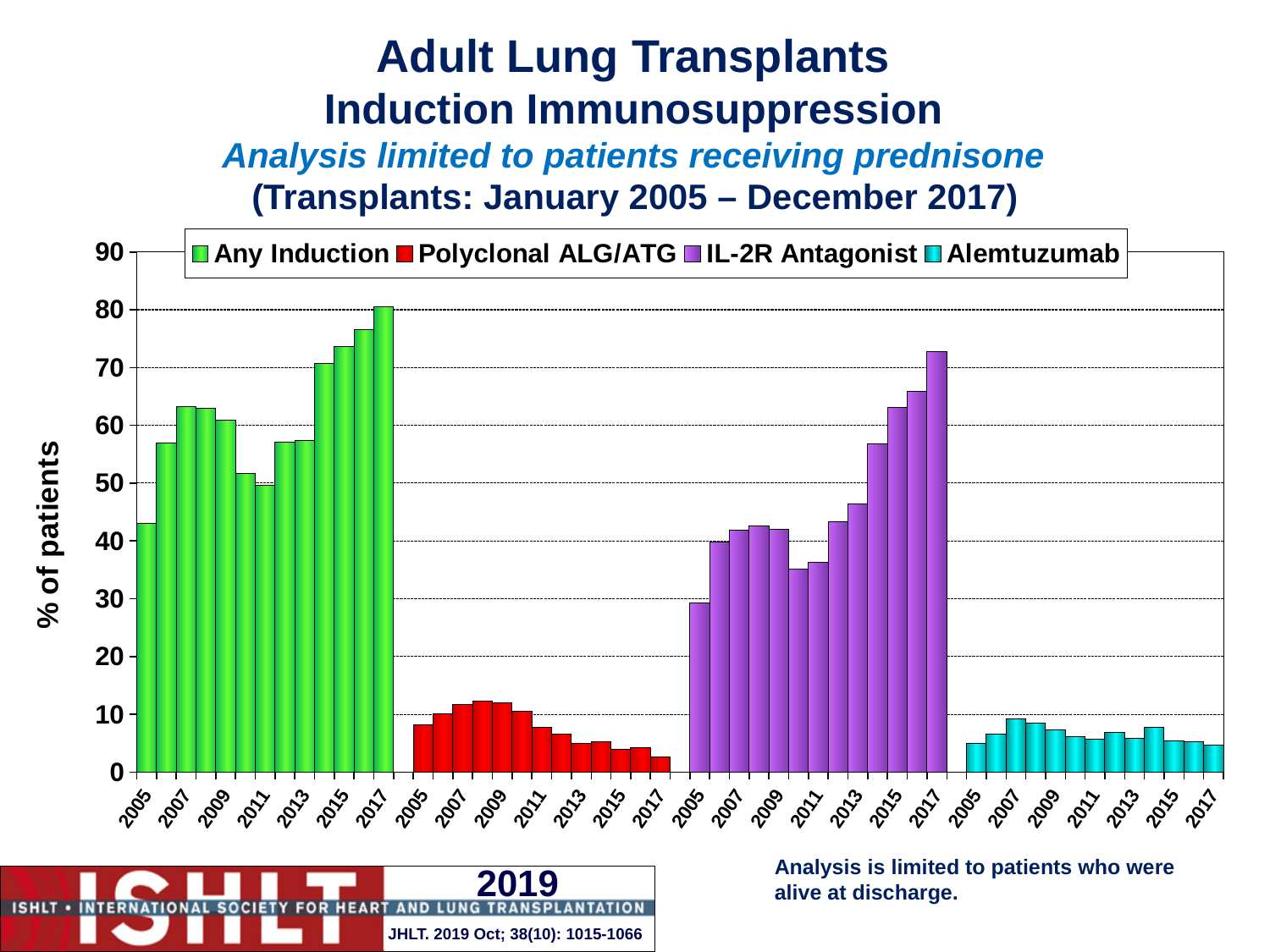
How many series does the legend list? 4 What kind of chart is shown on the slide? Bar chart In which year is the IL-2R Antagonist value highest? 2017 Which is larger in 2017: the IL-2R Antagonist value or the Alemtuzumab value? IL-2R Antagonist What is the label on the y axis? % of patients Do the Polyclonal ALG/ATG values rise or fall from 2009 to 2017? fall In which year is the Any Induction value highest? 2017 How many years are plotted for the Any Induction series? 13 In which year is the Polyclonal ALG/ATG value lowest? 2017 In which year is the Any Induction value lowest? 2005